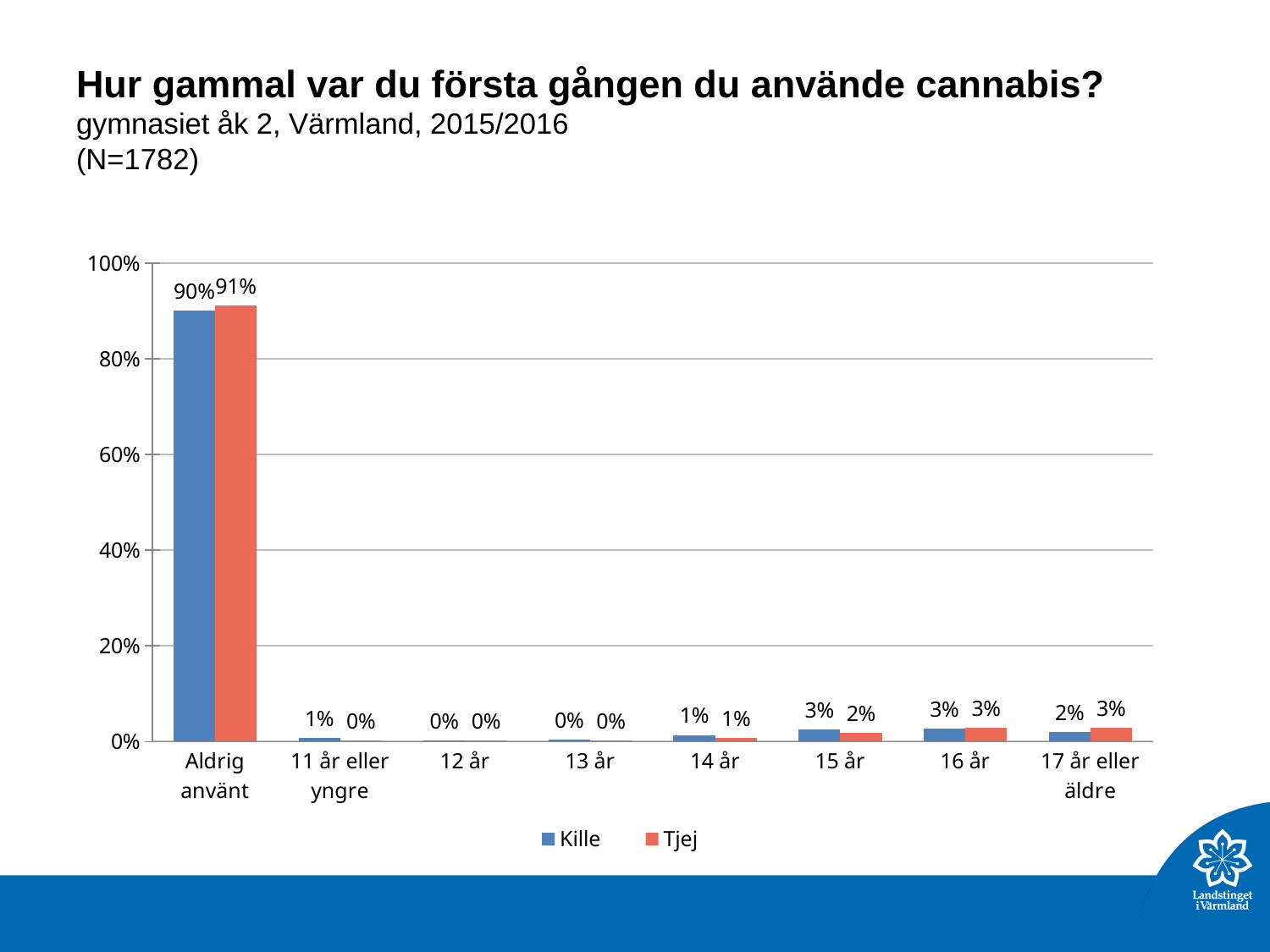
What is the value for Tjej in the 'Aldrig använt' category? 91% What is the value for Kille in the '16 år' category? 3% Which category has the highest value for Tjej? Aldrig använt What kind of chart is shown on the slide? Bar chart Is the value for Kille in 'Aldrig använt' greater or less than 80%? greater Which is larger in the '15 år' category, Kille or Tjej? Kille What is the value for Tjej in the '17 år eller äldre' category? 3% What is the value for Kille in the '11 år eller yngre' category? 1% How many categories are shown on the x axis? 8 How many series does the legend list? 2 What is the difference between the Tjej and Kille values in the 'Aldrig använt' category? 1% What is the value for Kille in the 'Aldrig använt' category? 90%